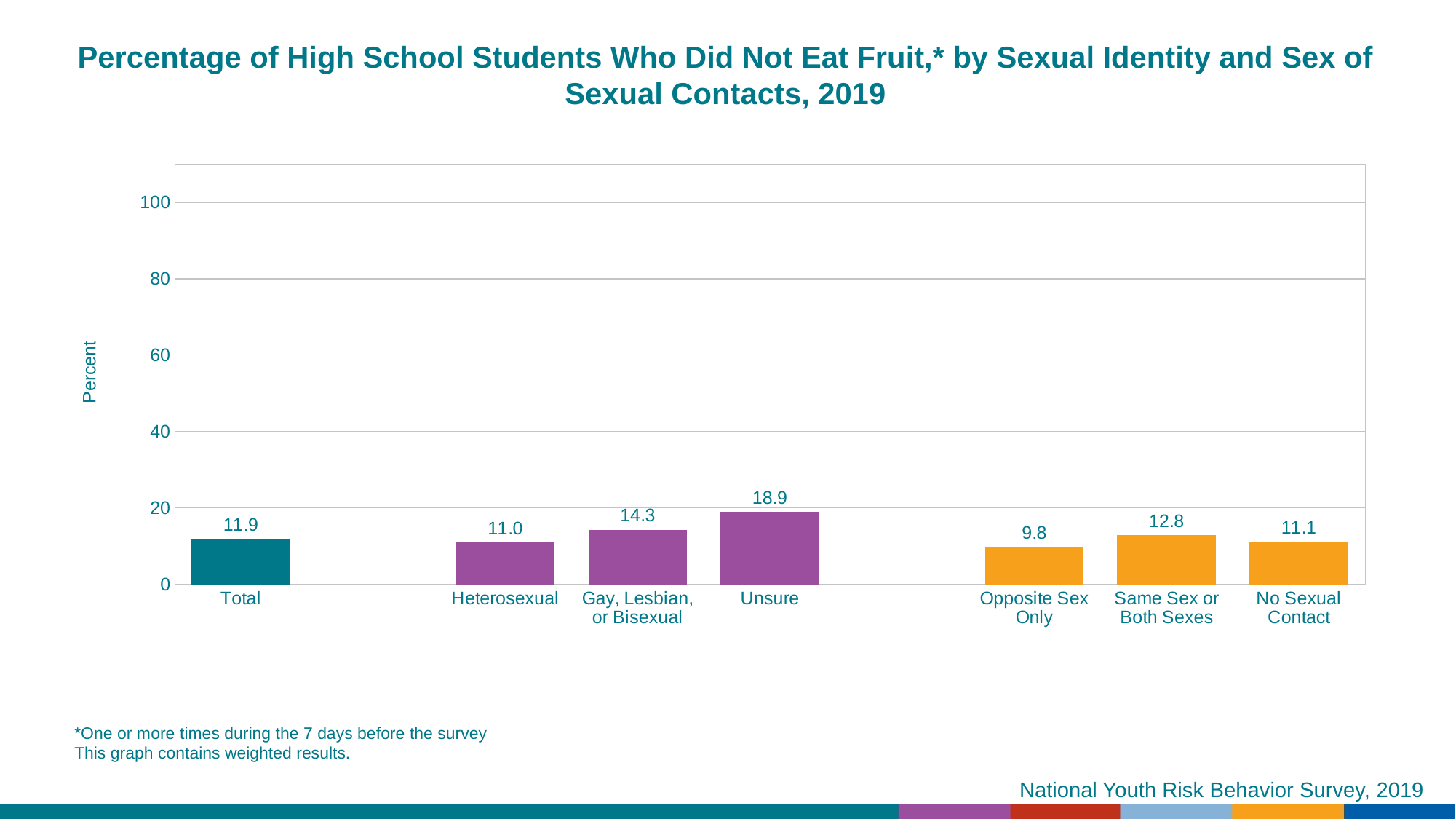
What is the value for Same Sex or Both Sexes? 12.8 What is the value for Unsure? 18.9 What is the value for Opposite Sex Only? 9.8 Is the value for Unsure greater or less than 20? less Which category has the lowest value? Opposite Sex Only How many categories are shown on the x axis? 7 What is the label of the y axis? Percent What is the value for Total? 11.9 Which category has the highest value? Unsure Which is larger, the value for Gay, Lesbian, or Bisexual or the value for No Sexual Contact? Gay, Lesbian, or Bisexual What is the difference between the values for Unsure and Heterosexual? 7.9 What kind of chart is this? bar chart